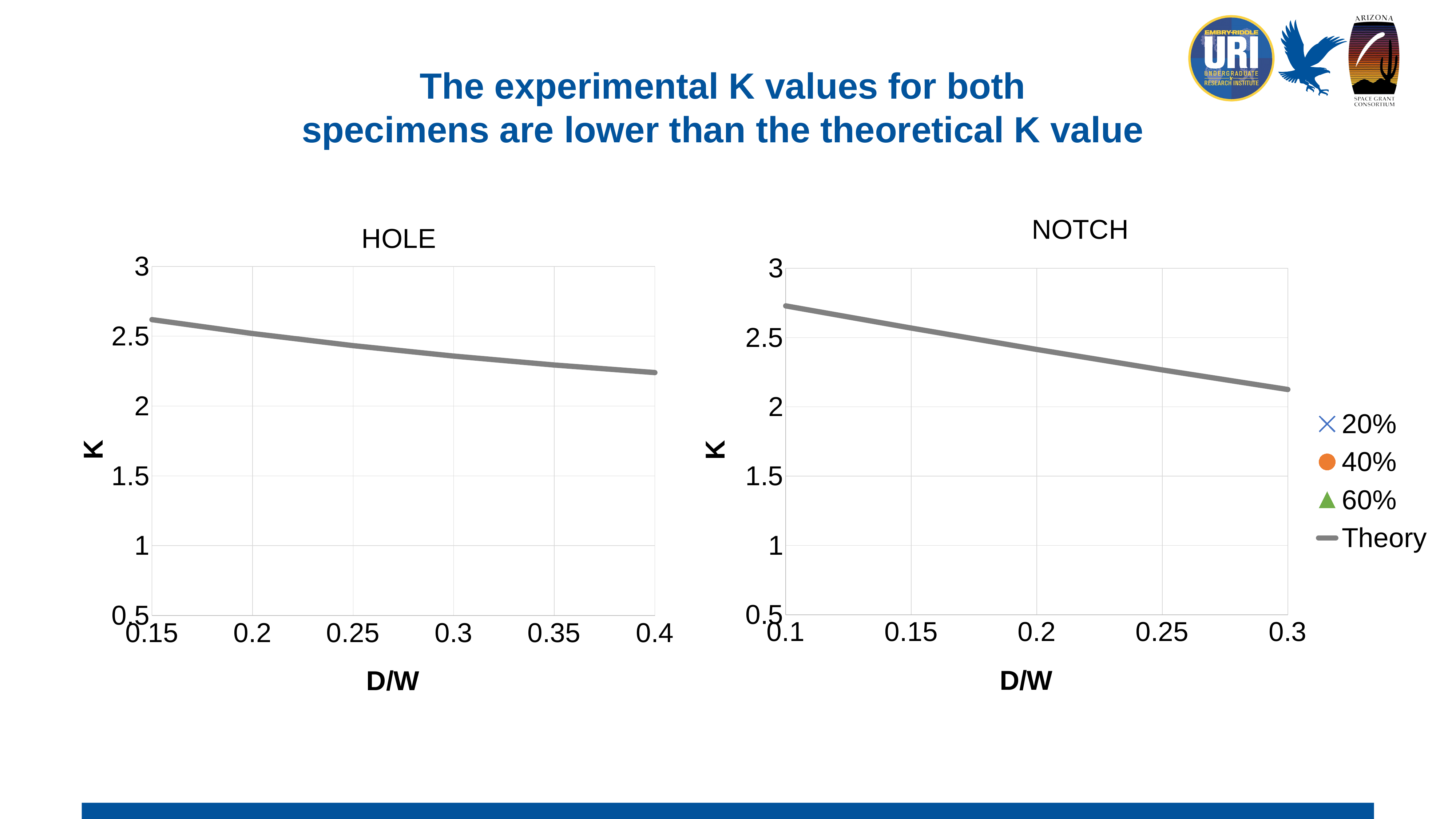
In the NOTCH chart, does the Theory line rise or fall as D/W increases? fall In the NOTCH chart, is the Theory value larger at D/W = 0.1 or at D/W = 0.3? 0.1 Which legend entry is drawn as a grey line? Theory How many series does the legend list? 4 In the HOLE chart, does the Theory line rise or fall as D/W increases? fall What kind of chart is the HOLE chart? line chart In the HOLE chart, is the Theory value at D/W = 0.4 greater or less than 2.5? less In the NOTCH chart, is the Theory value at D/W = 0.3 greater or less than 2.5? less What is the label of the x axis on the NOTCH chart? D/W In the HOLE chart, is the Theory value larger at D/W = 0.15 or at D/W = 0.4? 0.15 In the HOLE chart, is the Theory value at D/W = 0.15 greater or less than 2? greater